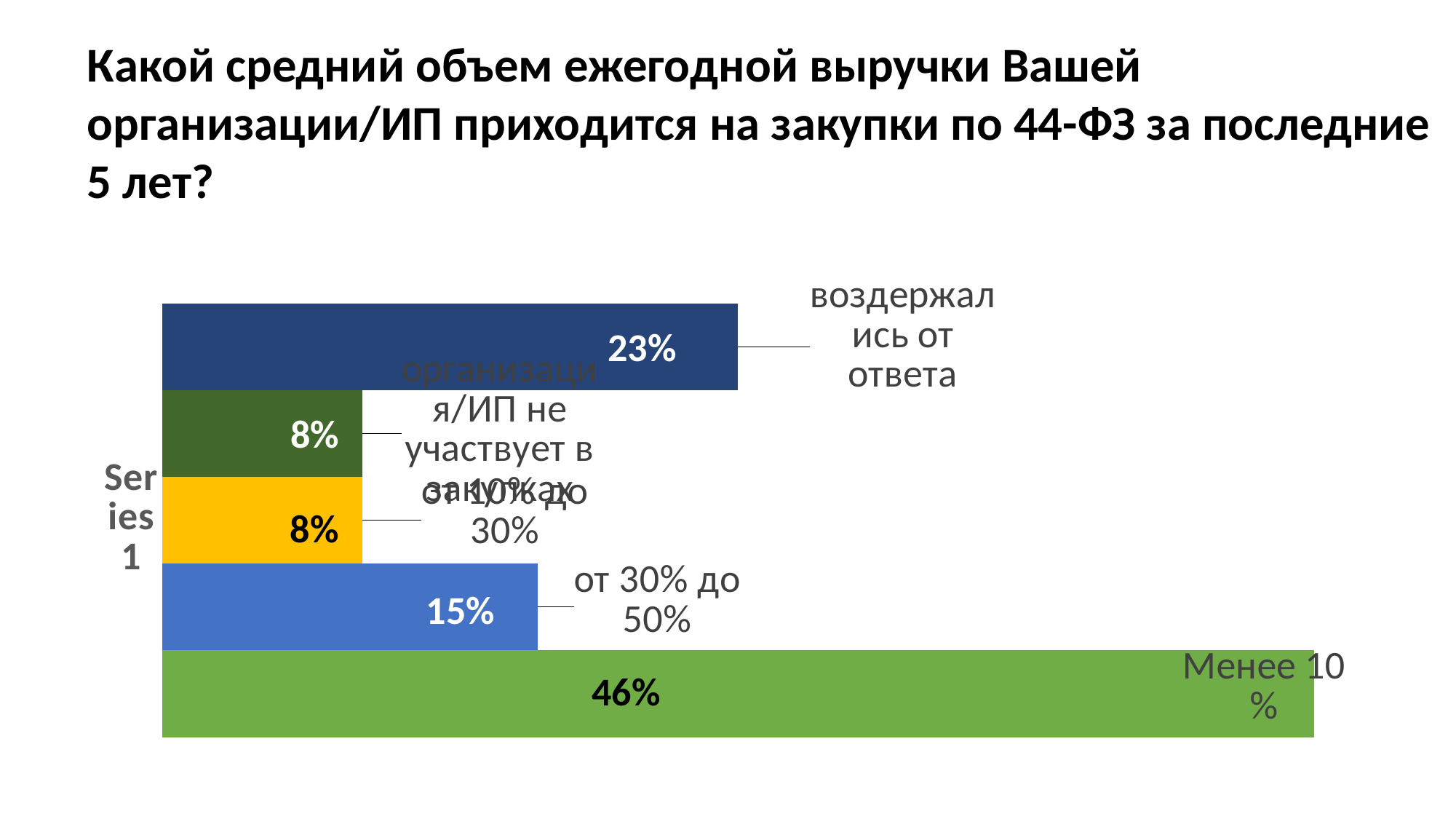
Which category has the highest value? Менее 10% What series name is shown on the vertical axis of the chart? Series 1 What kind of chart is shown on the slide? bar chart Which is larger, the value for "Менее 10%" or the value for "от 30% до 50%"? Менее 10% How many bars are plotted in the chart? 5 What is the value for "от 10% до 30%"? 8% What is the value for "Менее 10%"? 46% What is the difference between the values for "воздержались от ответа" and "от 30% до 50%"? 8% What is the value for "воздержались от ответа"? 23% What is the difference between the values for "Менее 10%" and "воздержались от ответа"? 23% What is the value for "от 30% до 50%"? 15% Which is larger, the value for "от 30% до 50%" or the value for "воздержались от ответа"? воздержались от ответа